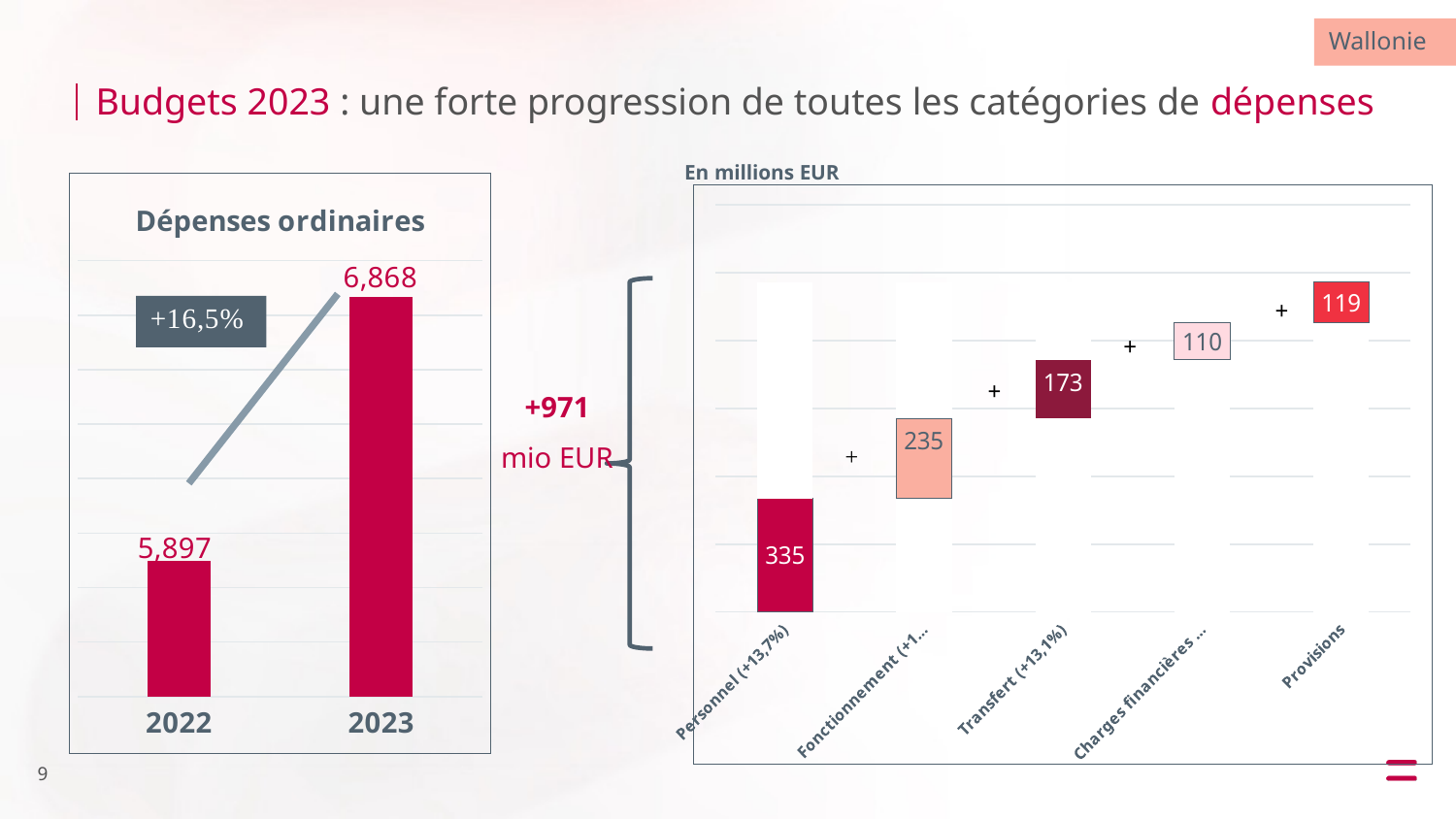
In the chart on the right (En millions EUR), how many categories are shown? 5 In the chart on the right (En millions EUR), what is the value for Transfert? 173 In the 'Dépenses ordinaires' chart on the left, do the values rise or fall from 2022 to 2023? rise In the 'Dépenses ordinaires' chart on the left, what percentage change is shown in the label between the two bars? +16,5% In the 'Dépenses ordinaires' chart on the left, what is the value for 2022? 5,897 In the chart on the right (En millions EUR), what is the value for Personnel? 335 In the chart on the right (En millions EUR), what is the value for Fonctionnement? 235 In the chart on the right (En millions EUR), what is the value for Provisions? 119 What kind of chart is the 'Dépenses ordinaires' chart on the left? bar chart In the chart on the right (En millions EUR), which category has the highest value? Personnel In the 'Dépenses ordinaires' chart on the left, what is the difference between the 2023 and 2022 values? 971 In the 'Dépenses ordinaires' chart on the left, what is the value for 2023? 6,868